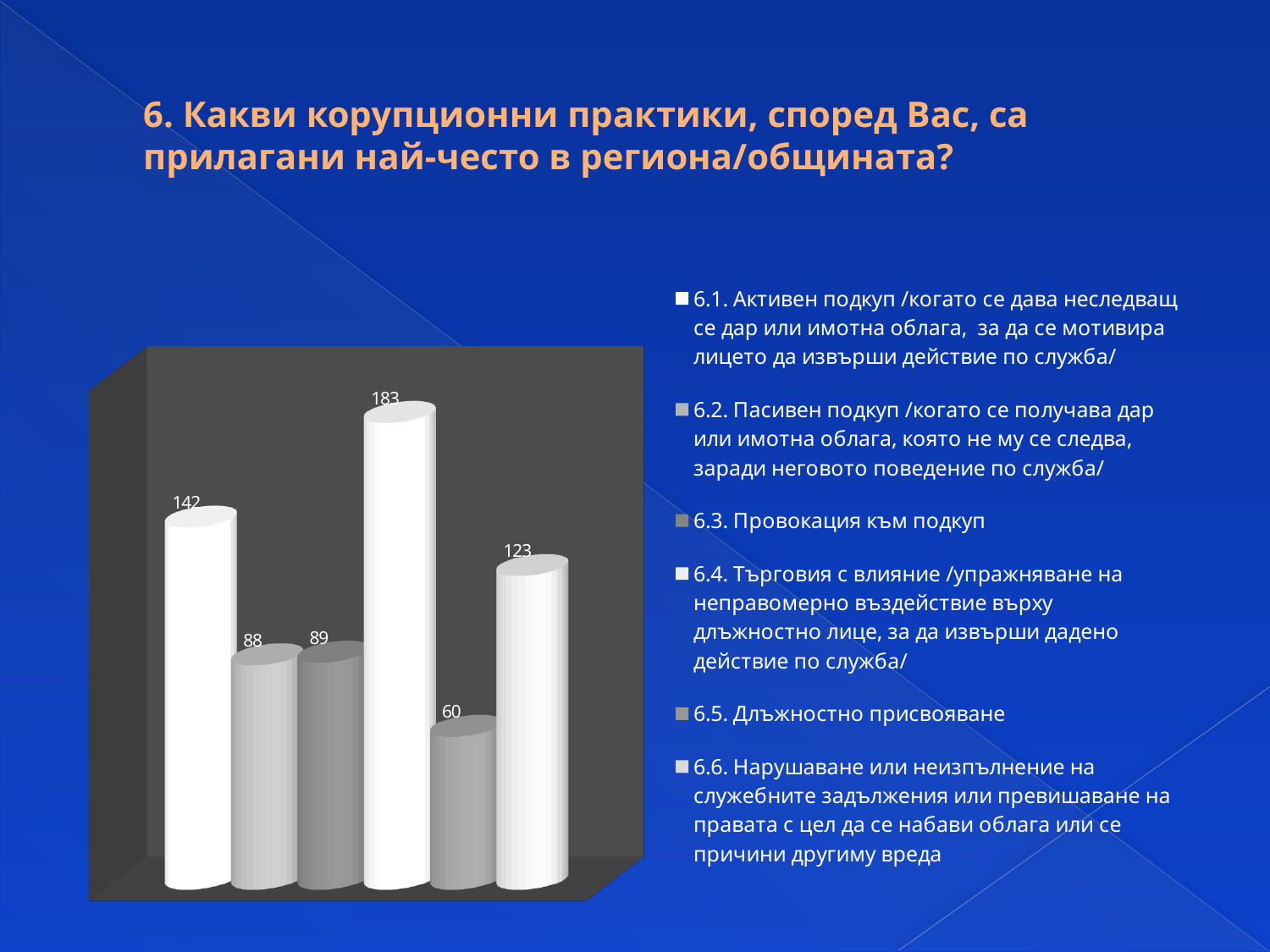
How many bars are plotted in the chart? 6 What value is shown for 6.1. Активен подкуп? 142 What is the difference between the values for 6.4. Търговия с влияние and 6.1. Активен подкуп? 41 What is the difference between the values for 6.6. Нарушаване или неизпълнение на служебните задължения and 6.5. Длъжностно присвояване? 63 What kind of chart is shown on the slide? Bar chart What value is shown for 6.6. Нарушаване или неизпълнение на служебните задължения? 123 Which category has the lowest value? 6.5. Длъжностно присвояване What value is shown for 6.5. Длъжностно присвояване? 60 How many entries does the legend list? 6 Which category has the highest value? 6.4. Търговия с влияние Which is larger, the value for 6.1. Активен подкуп or the value for 6.6. Нарушаване или неизпълнение на служебните задължения? 6.1. Активен подкуп What value is shown for 6.4. Търговия с влияние? 183